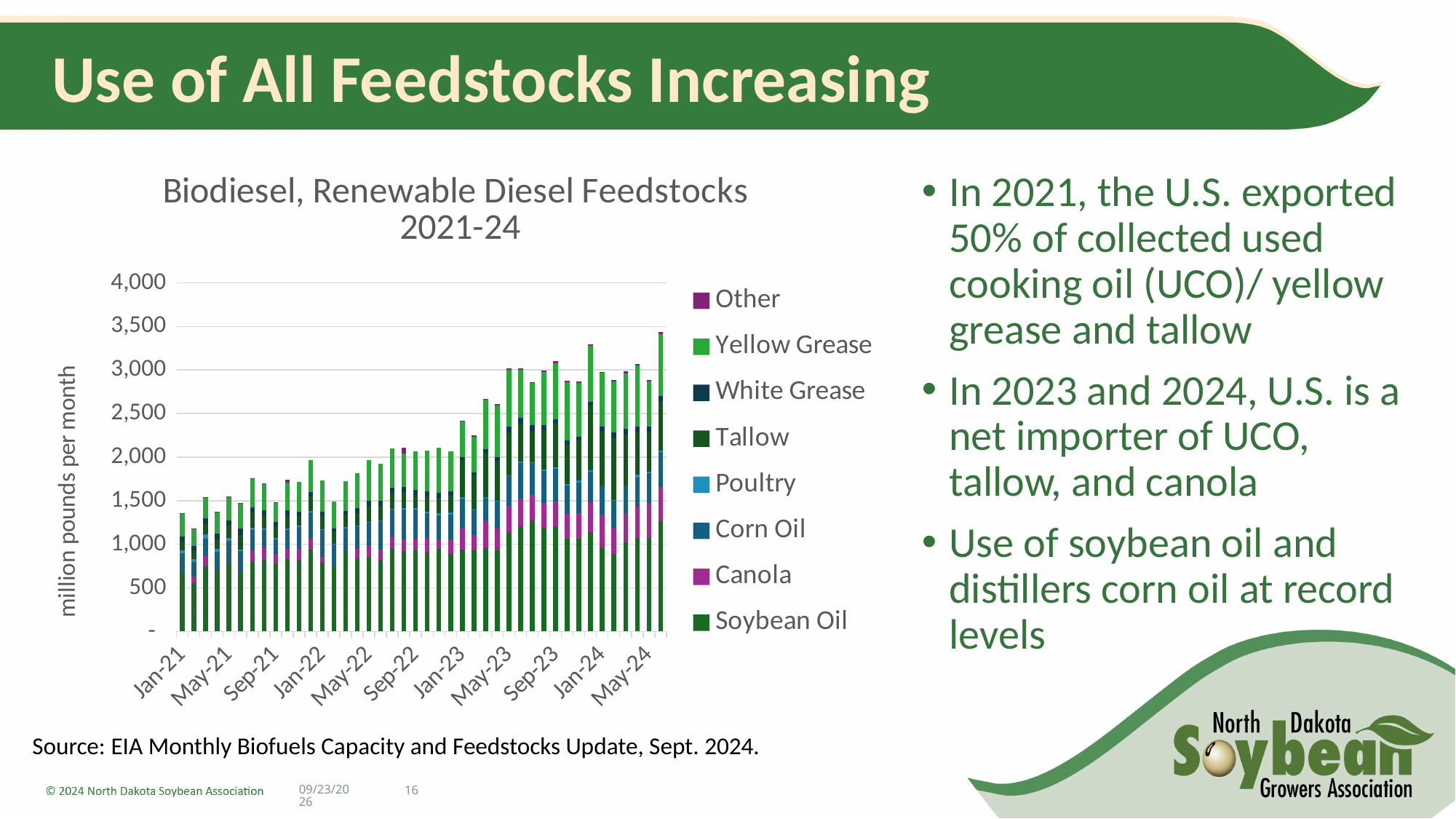
Which series forms the bottom segment of each stacked bar? Soybean Oil Is the total value for Jan-21 greater or less than 1,000? greater Which is larger, the total bar for Jan-21 or the total bar for May-24? May-24 What type of chart is shown on the slide? Stacked bar chart How many series does the chart's legend list? 8 What is the title of the chart? Biodiesel, Renewable Diesel Feedstocks 2021-24 Is the total value for Sep-21 greater or less than 2,000? less Do the total feedstock values generally rise or fall from Jan-21 to May-24? rise What is the highest value shown on the vertical axis? 4,000 What is the label on the vertical axis of the chart? million pounds per month Is the tallest bar in the chart greater or less than 3,000? greater